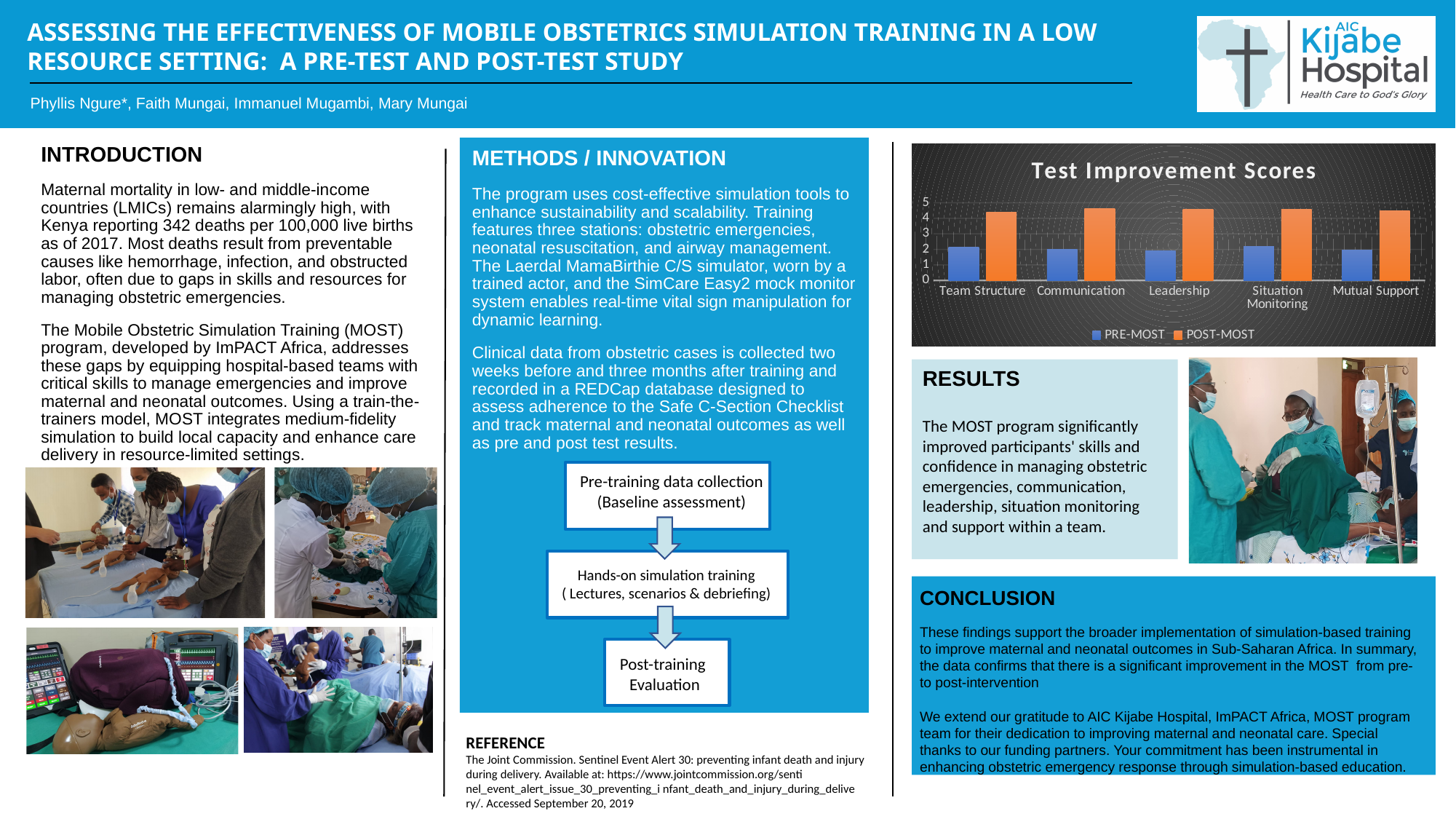
Is the PRE-MOST value for Leadership greater or less than 1? greater Is the PRE-MOST value for Team Structure greater or less than 3? less Is the POST-MOST value for Communication greater or less than 4? greater What is the title of the chart on the slide? Test Improvement Scores What kind of chart is shown on the slide? bar chart For Leadership, which is larger: the PRE-MOST value or the POST-MOST value? POST-MOST How many series does the chart's legend list? 2 Which series is shown in orange in the chart? POST-MOST How many categories are shown on the x axis of the chart? 5 For Situation Monitoring, which is larger: the PRE-MOST value or the POST-MOST value? POST-MOST